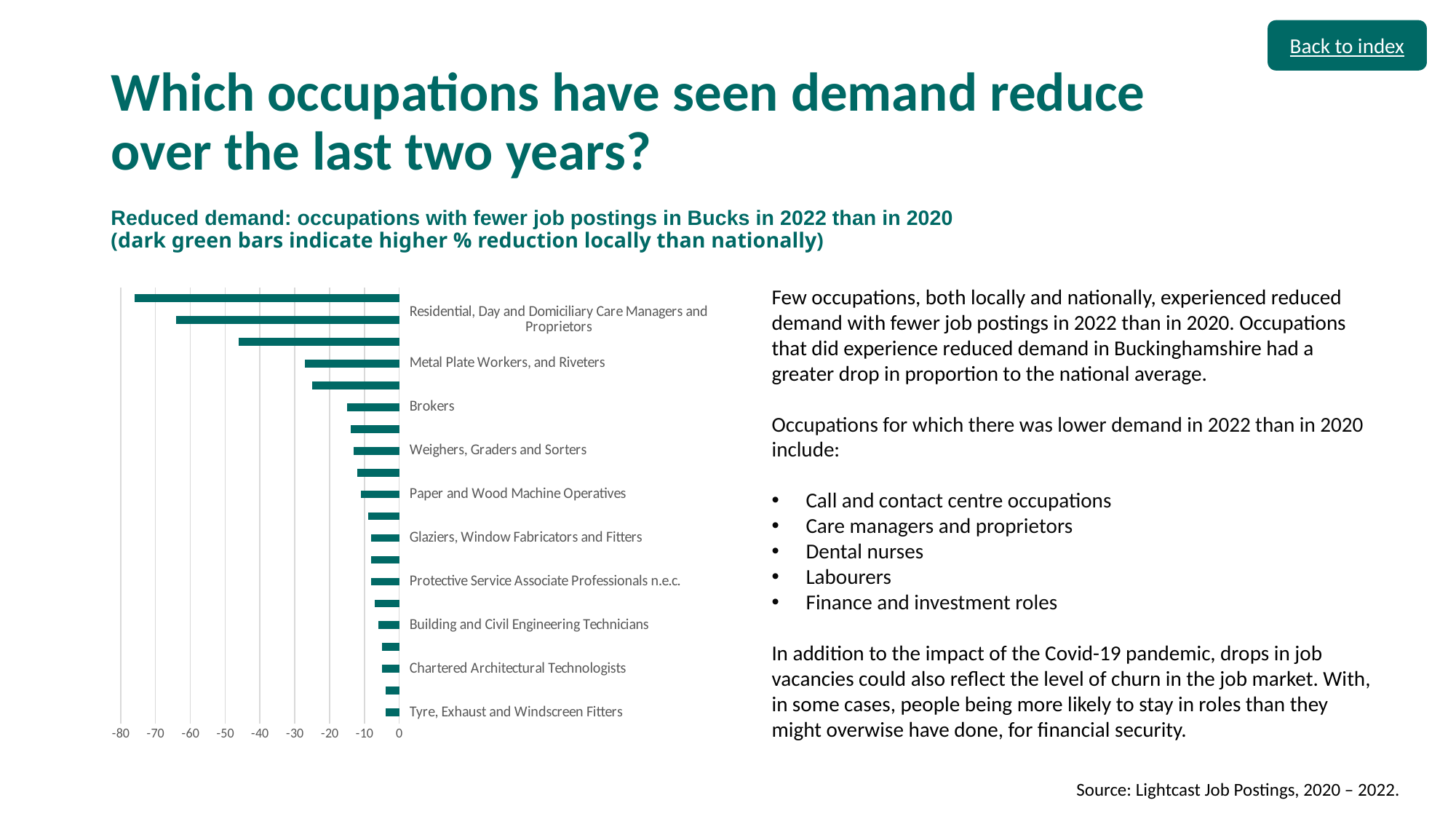
Is the value for Metal Plate Workers, and Riveters greater or less than -40? greater Which labelled occupation shows the largest percentage reduction in job postings? Residential, Day and Domiciliary Care Managers and Proprietors What is the lowest value shown on the chart's horizontal axis? -80 According to the chart subtitle, what do dark green bars indicate? higher % reduction locally than nationally Which shows a larger percentage reduction: Metal Plate Workers, and Riveters or Brokers? Metal Plate Workers, and Riveters Which labelled occupation shows the smallest percentage reduction in job postings? Tyre, Exhaust and Windscreen Fitters Is the value for Brokers greater or less than -20? greater Is the value for Residential, Day and Domiciliary Care Managers and Proprietors greater or less than -50? less How many occupation labels are readable on the chart's axis? 10 What kind of chart is shown on the slide? bar chart